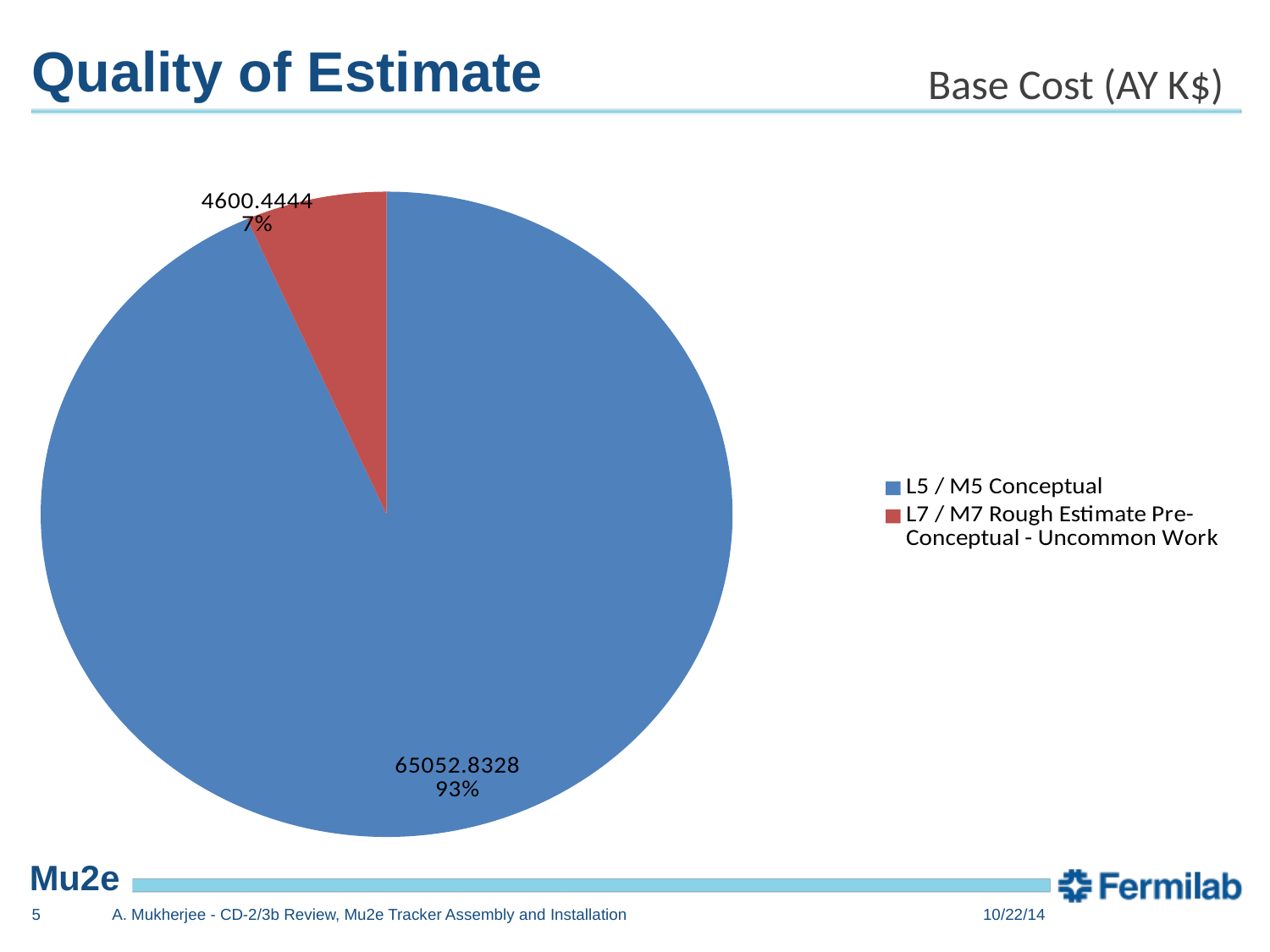
What is the value for L5 / M5 Conceptual? 65052.8328 What is the difference between the value for L5 / M5 Conceptual and the value for L7 / M7 Rough Estimate Pre-Conceptual - Uncommon Work? 60452.3884 What kind of chart is shown on the slide? pie chart What share of the pie does L7 / M7 Rough Estimate Pre-Conceptual - Uncommon Work represent? 7% What is the value for L7 / M7 Rough Estimate Pre-Conceptual - Uncommon Work? 4600.4444 Which category has the largest slice of the pie? L5 / M5 Conceptual How many slices does the pie chart have? 2 What colour is the slice for L7 / M7 Rough Estimate Pre-Conceptual - Uncommon Work? red What share of the pie does L5 / M5 Conceptual represent? 93% Which is larger, the value for L5 / M5 Conceptual or the value for L7 / M7 Rough Estimate Pre-Conceptual - Uncommon Work? L5 / M5 Conceptual Which category has the smallest slice of the pie? L7 / M7 Rough Estimate Pre-Conceptual - Uncommon Work